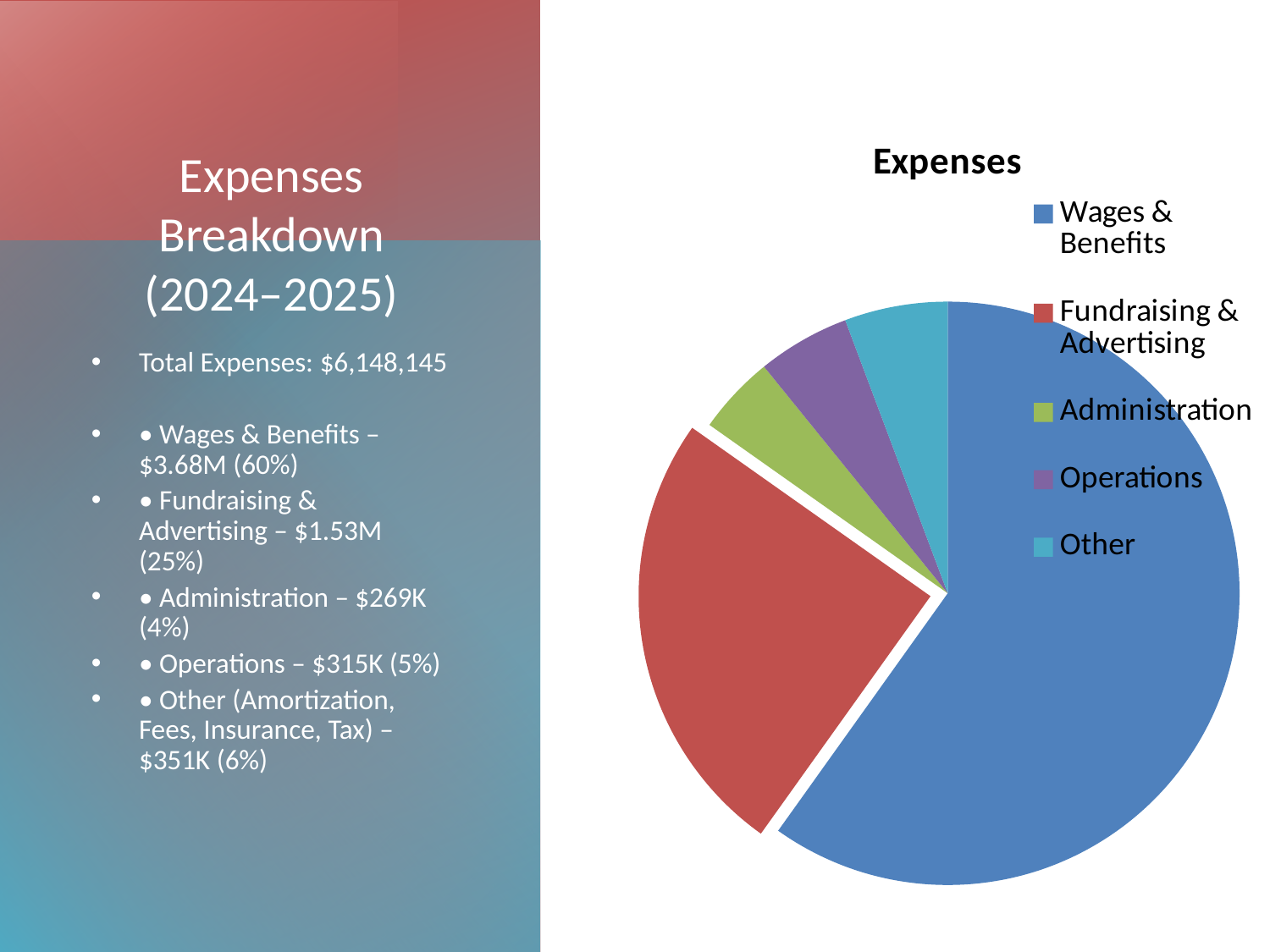
How many slices does the pie chart have? 5 According to the slide, what share of expenses does Other represent? 6% Which slice is larger, Fundraising & Advertising or Administration? Fundraising & Advertising What kind of chart is shown on the slide? pie chart Which slice is pulled out (exploded) from the pie? Fundraising & Advertising Which slice is larger, Wages & Benefits or Fundraising & Advertising? Wages & Benefits Which slice is larger, Fundraising & Advertising or Other? Fundraising & Advertising What is the title of the chart? Expenses According to the slide, what share of expenses does Wages & Benefits represent? 60% Which category has the largest slice of the pie? Wages & Benefits How many entries does the chart legend list? 5 According to the slide, what share of expenses does Fundraising & Advertising represent? 25%